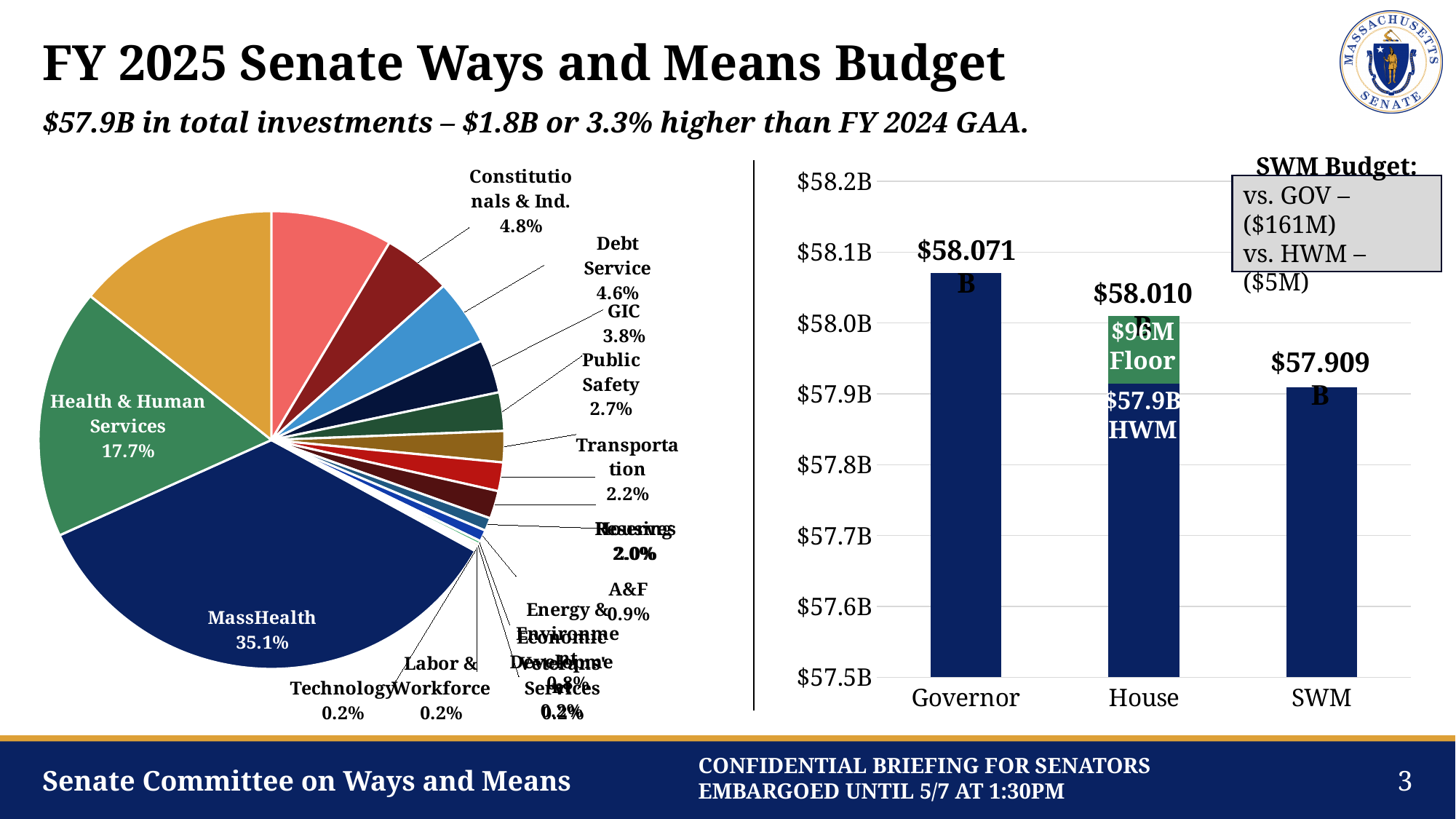
On the bar chart on the right, what is the value for Governor? $58.071B On the bar chart on the right, what is the value for SWM? $57.909B On the bar chart on the right, how many categories are shown on the x axis? 3 On the pie chart on the left, which slice is the largest? MassHealth On the bar chart on the right, do the values rise or fall from Governor to SWM? fall On the bar chart on the right, which category has the highest value? Governor On the pie chart on the left, what share does MassHealth have? 35.1% On the pie chart on the left, which is larger: Health & Human Services or Debt Service? Health & Human Services On the bar chart on the right, is the value for SWM greater or less than $58.0B? less On the bar chart on the right, which category has the lowest value? SWM On the bar chart on the right, what is the difference between the Governor and House values? $0.061B On the bar chart on the right, what is the value for House? $58.010B